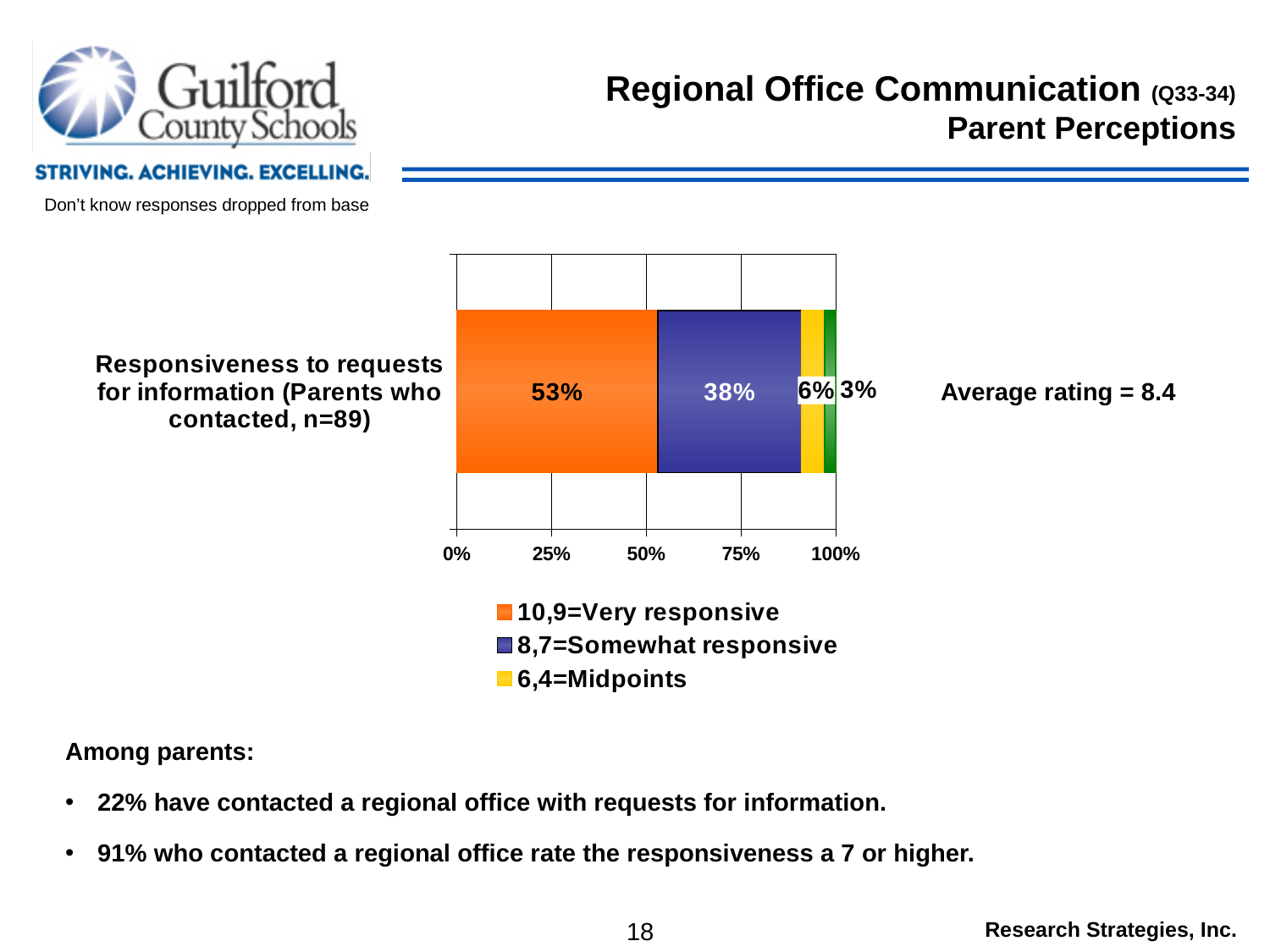
What colour represents 10,9=Very responsive in the legend? Orange How many bars (categories) does the chart show? 1 Which is larger, the Somewhat responsive segment or the Midpoints segment? 8,7=Somewhat responsive What percentage of parents rated responsiveness as 10,9=Very responsive? 53% How many series does the legend list? 3 What kind of chart is shown on the slide? Stacked bar chart What percentage of parents gave a 6,4=Midpoints rating for responsiveness? 6% Which legend category has the largest share of the bar? 10,9=Very responsive What is the difference in percentage points between the Very responsive and Somewhat responsive segments? 15 What is the value of the smallest segment in the bar? 3% What percentage of parents rated responsiveness as 8,7=Somewhat responsive? 38% Is the value for 10,9=Very responsive greater or less than 50%? greater